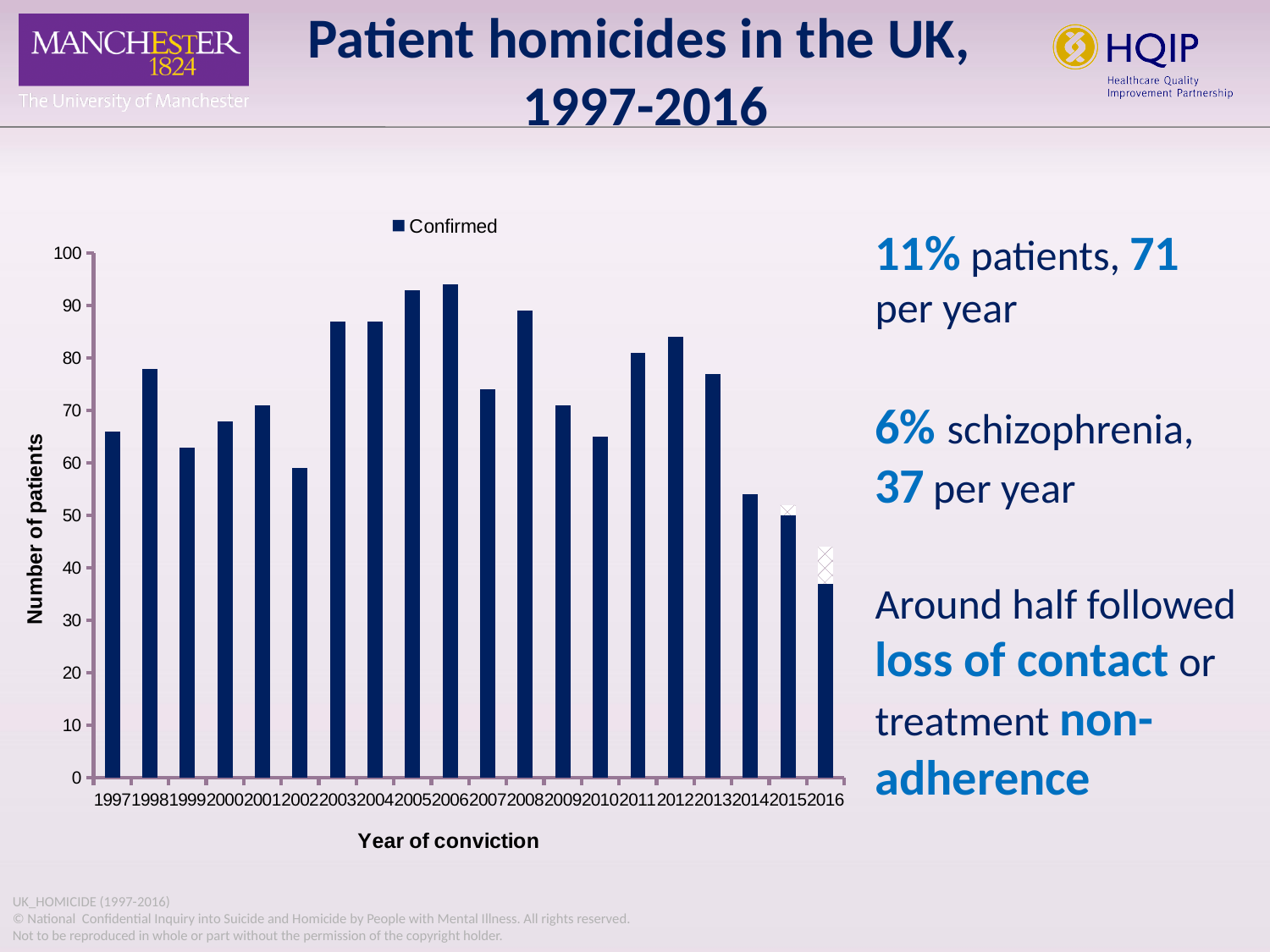
Is the number of patients for 1997 greater or less than 60? greater How many years are shown on the x axis of the chart? 20 Is the number of patients for 2003 greater or less than 80? greater Which year has the lowest number of patients in the chart? 2016 What kind of chart is shown on the slide? bar chart Do the values rise or fall from 2013 to 2016? fall Is the number of patients for 2010 greater or less than 70? less Which year has more patients, 2003 or 1997? 2003 How many series does the chart legend list? 1 Which year has more patients, 2011 or 2014? 2011 What is the title of the x axis of the chart? Year of conviction